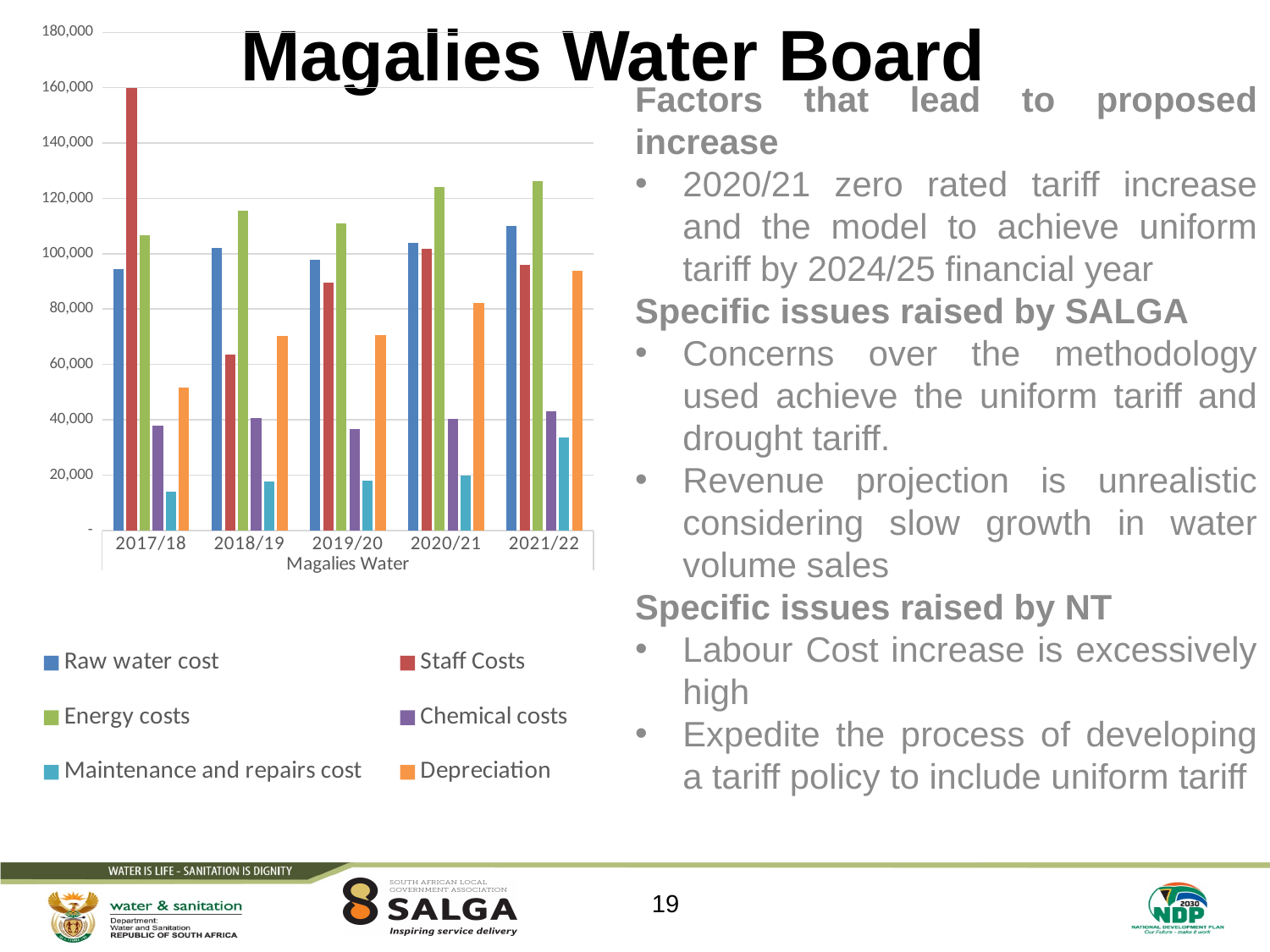
Is the value for Maintenance and repairs cost in 2017/18 greater or less than 20,000? less Is the value for Staff Costs in 2017/18 greater or less than 140,000? greater Which financial year has the highest Depreciation value? 2021/22 Is the value for Raw water cost in 2021/22 greater or less than 100,000? greater In 2017/18, which is larger: Staff Costs or Energy costs? Staff Costs How many series does the chart legend list? 6 Does the Depreciation series rise or fall from 2017/18 to 2021/22? Rises How many financial years are shown on the x axis of the chart? 5 What kind of chart is shown on the slide? Bar chart In 2021/22, which is larger: Energy costs or Staff Costs? Energy costs What label appears beneath the year categories on the x axis? Magalies Water